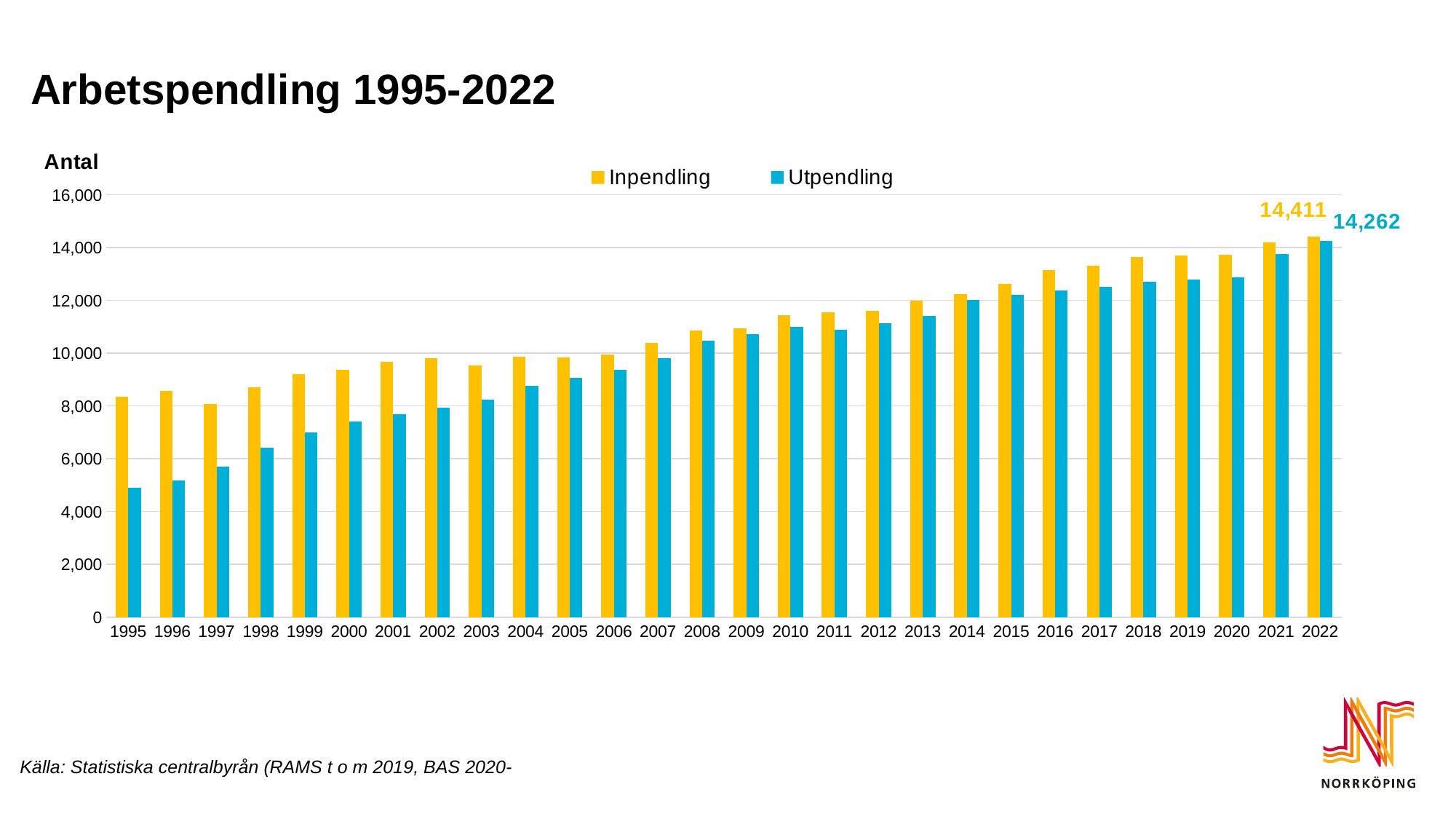
Does Utpendling generally rise or fall from 1995 to 2022? Rise How many years are shown on the x axis? 28 Which is larger in 1995, Inpendling or Utpendling? Inpendling What is the difference between Inpendling and Utpendling in 2022? 149 How many series does the legend list? 2 In which year is Utpendling lowest? 1995 What is the value for Utpendling in 2022? 14,262 What kind of chart is shown on the slide? Bar chart Is the value for Utpendling in 1995 greater or less than 6,000? less Is the value for Inpendling in 1995 greater or less than 8,000? greater Which is larger in 2022, Inpendling or Utpendling? Inpendling What is the value for Inpendling in 2022? 14,411